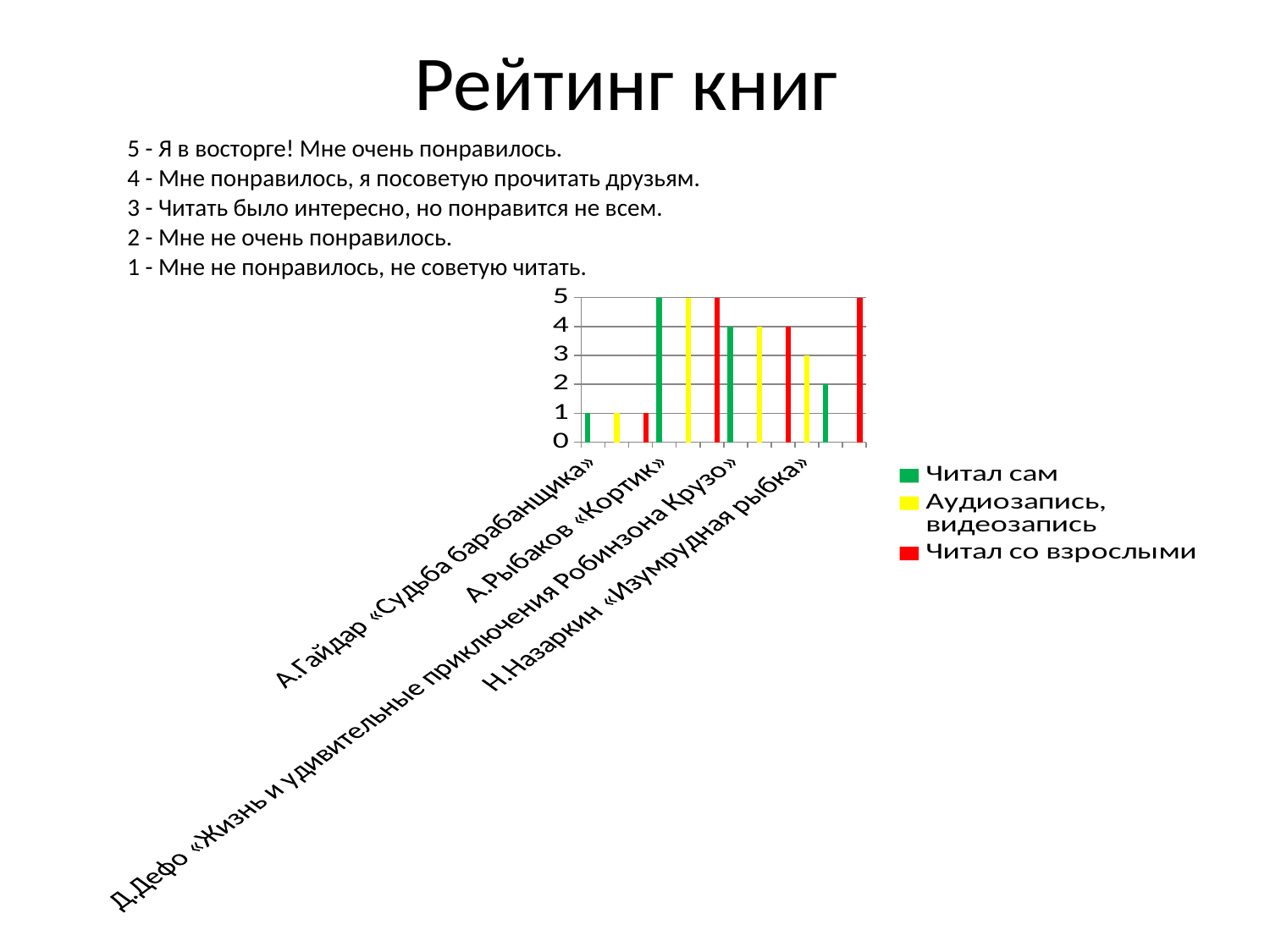
Is the value of «Читал сам» for Д.Дефо «Жизнь и удивительные приключения Робинзона Крузо» greater or less than 2? greater What colour represents the series «Читал со взрослыми» in the legend? red Which is larger: «Читал сам» for А.Рыбаков «Кортик» or for Д.Дефо «Жизнь и удивительные приключения Робинзона Крузо»? А.Рыбаков «Кортик» What kind of chart is shown on the slide? bar chart What is the value of «Читал сам» for А.Рыбаков «Кортик»? 5 How many series does the legend list? 3 Which book has the lowest value for «Читал сам»? А.Гайдар «Судьба барабанщика»